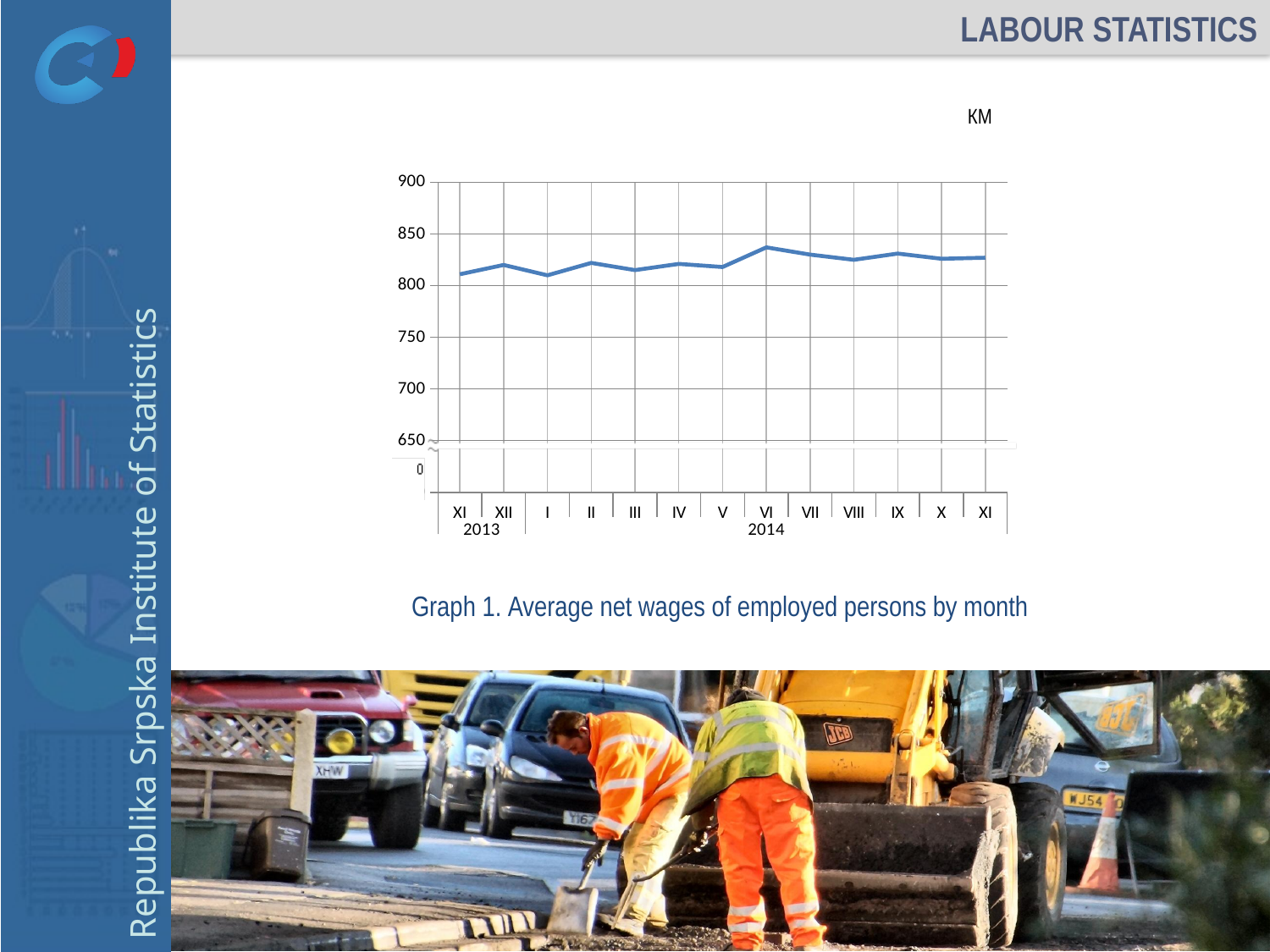
Which month has the highest average net wage on the chart? VI 2014 Does the line rise or fall from V 2014 to VI 2014? rise Is the value for XI 2013 greater or less than 850? less Which is larger, the value for VI 2014 or the value for III 2014? VI 2014 Is the value for VI 2014 greater or less than 800? greater Is the value for IX 2014 greater or less than 800? greater What unit is shown above the chart? KM How many monthly data points are plotted on the chart? 13 What is the title of the graph? Graph 1. Average net wages of employed persons by month What kind of chart is shown on the slide? line chart Which is larger, the value for XI 2013 or the value for VI 2014? VI 2014